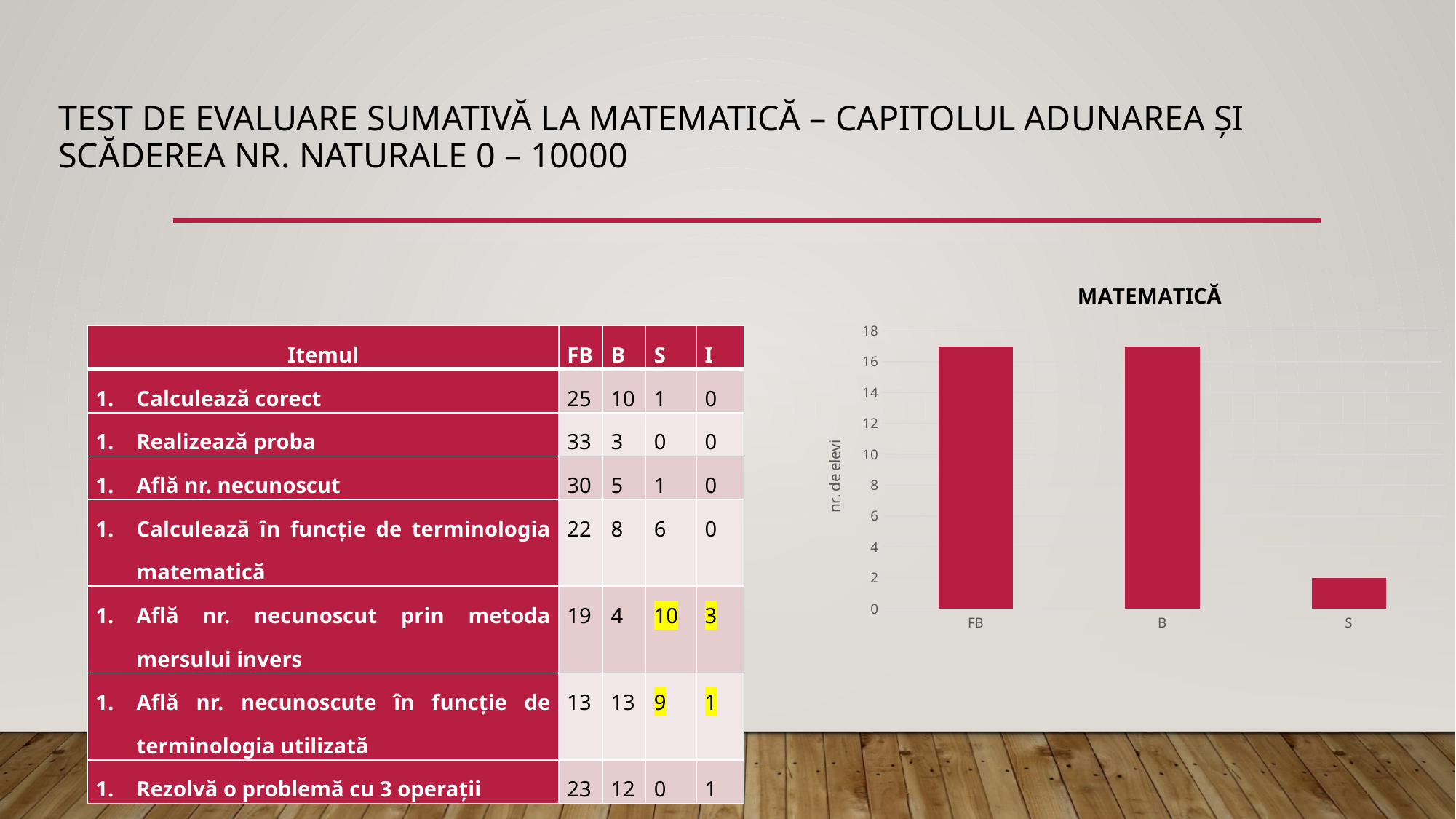
What is the label of the vertical axis of the chart? nr. de elevi Which category has the lowest value in the chart? S Is the value for B greater or less than 14? greater How many categories are shown on the x axis of the chart? 3 What is the title of the chart? MATEMATICĂ Which is larger in the chart, the value for B or the value for S? B Which is larger in the chart, the value for FB or the value for S? FB Is the value for S greater or less than 10? less What kind of chart is shown on the slide? bar chart Is the value for FB greater or less than 10? greater What is the value for S in the chart? 2